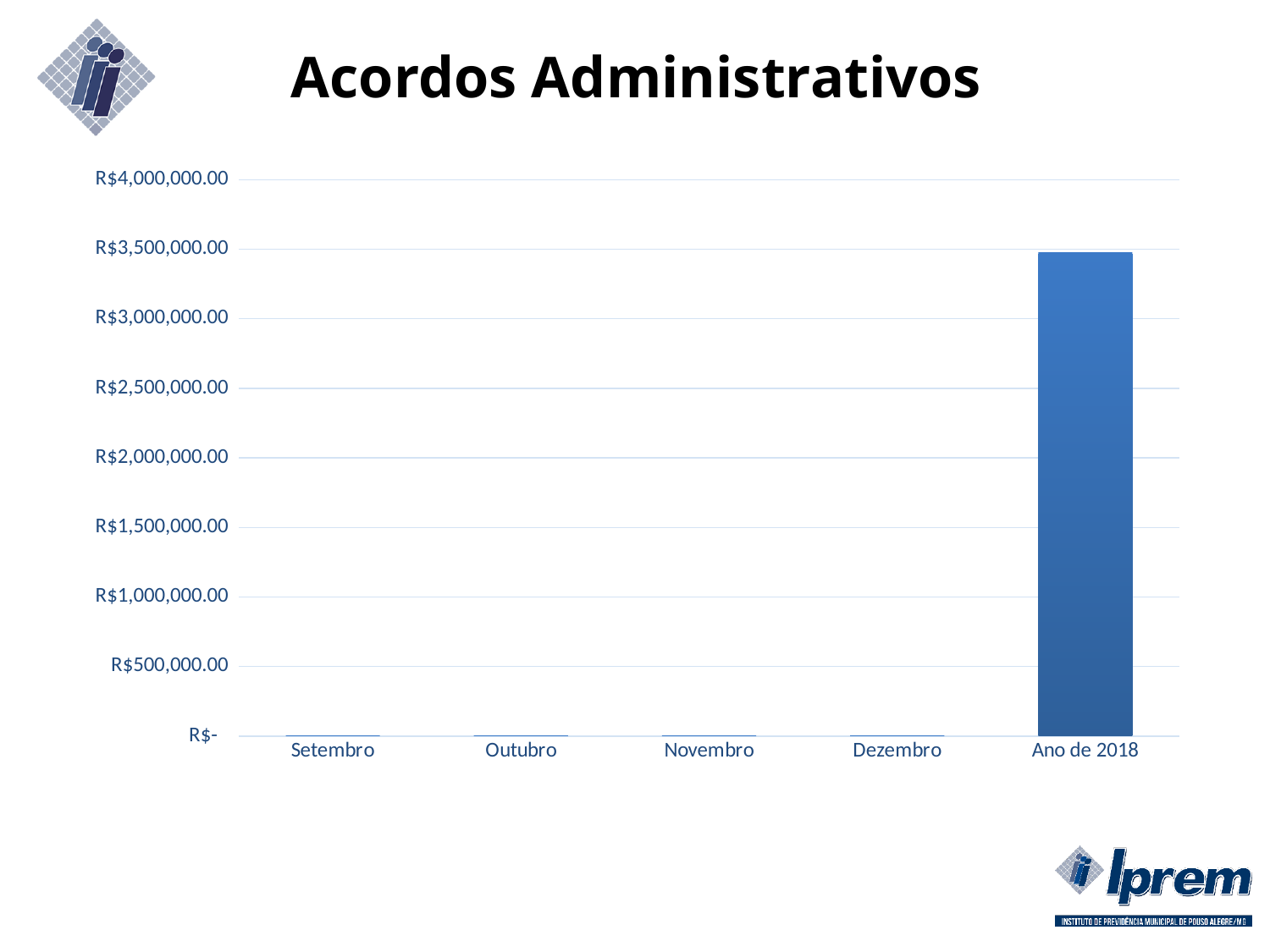
Is the value for Setembro greater or less than R$500,000.00? less What kind of chart is shown on the slide? bar chart Is the value for Ano de 2018 greater or less than R$3,000,000.00? greater How many categories are shown on the x axis of the chart? 5 Is the value for Ano de 2018 greater or less than R$4,000,000.00? less What is the title of the chart? Acordos Administrativos Which is larger, the value for Ano de 2018 or the value for Novembro? Ano de 2018 What is the highest value shown on the y axis of the chart? R$4,000,000.00 Which category has the highest value in the chart? Ano de 2018 What is the label of the last category on the x axis? Ano de 2018 Which is larger, the value for Outubro or the value for Ano de 2018? Ano de 2018